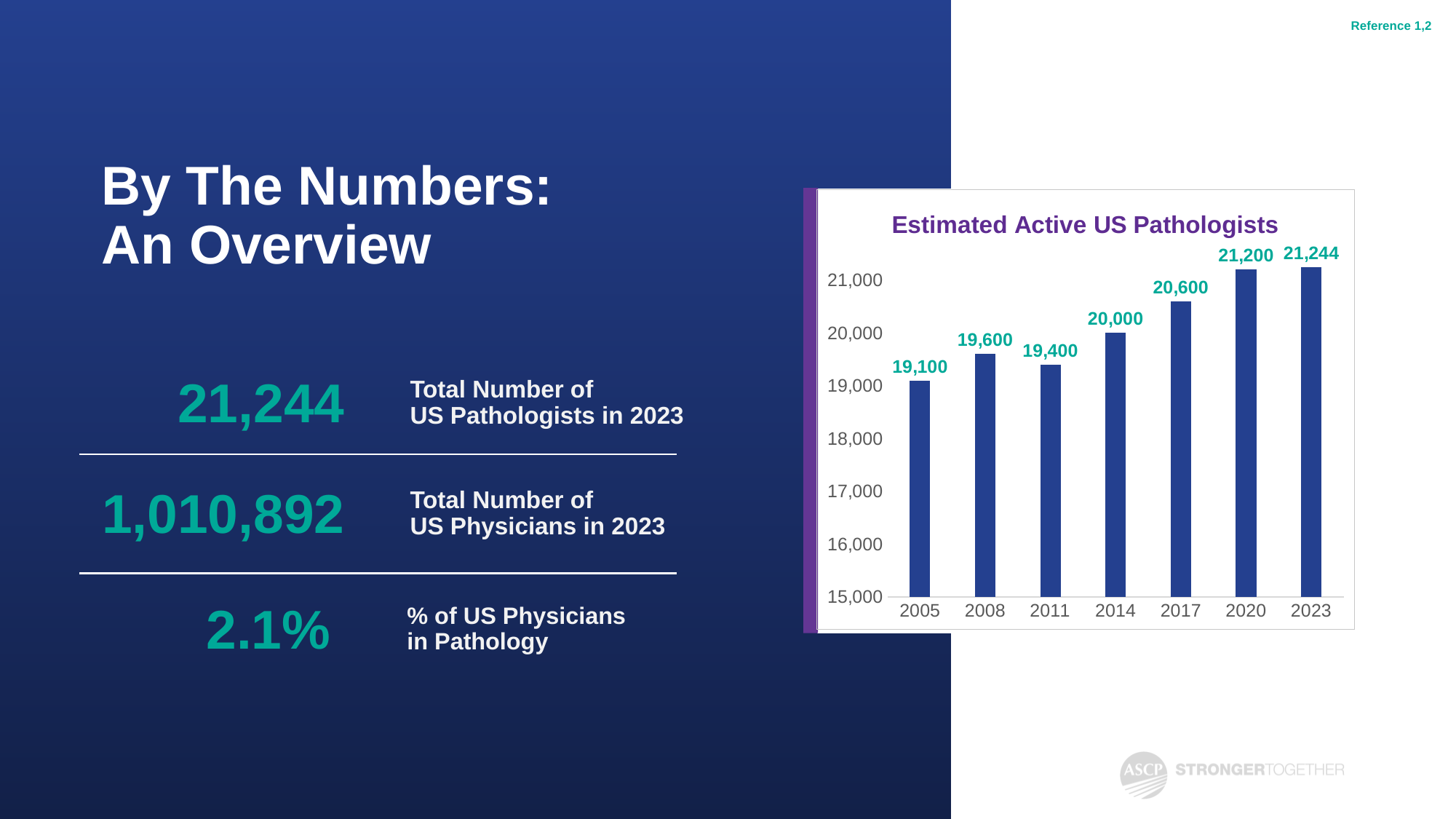
Which is larger in the Estimated Active US Pathologists chart, the value for 2008 or the value for 2011? 2008 What is the title of the chart on the slide? Estimated Active US Pathologists How many years are shown in the Estimated Active US Pathologists chart? 7 What is the value for 2014 in the Estimated Active US Pathologists chart? 20,000 Which year has the lowest value in the Estimated Active US Pathologists chart? 2005 Which year has the highest value in the Estimated Active US Pathologists chart? 2023 What is the difference between the 2008 and 2011 values in the Estimated Active US Pathologists chart? 200 What kind of chart is the Estimated Active US Pathologists chart? bar chart Is the value for 2017 in the Estimated Active US Pathologists chart greater or less than 20,000? greater What is the difference between the 2023 and 2005 values in the Estimated Active US Pathologists chart? 2,144 What is the value for 2005 in the Estimated Active US Pathologists chart? 19,100 What is the value for 2023 in the Estimated Active US Pathologists chart? 21,244